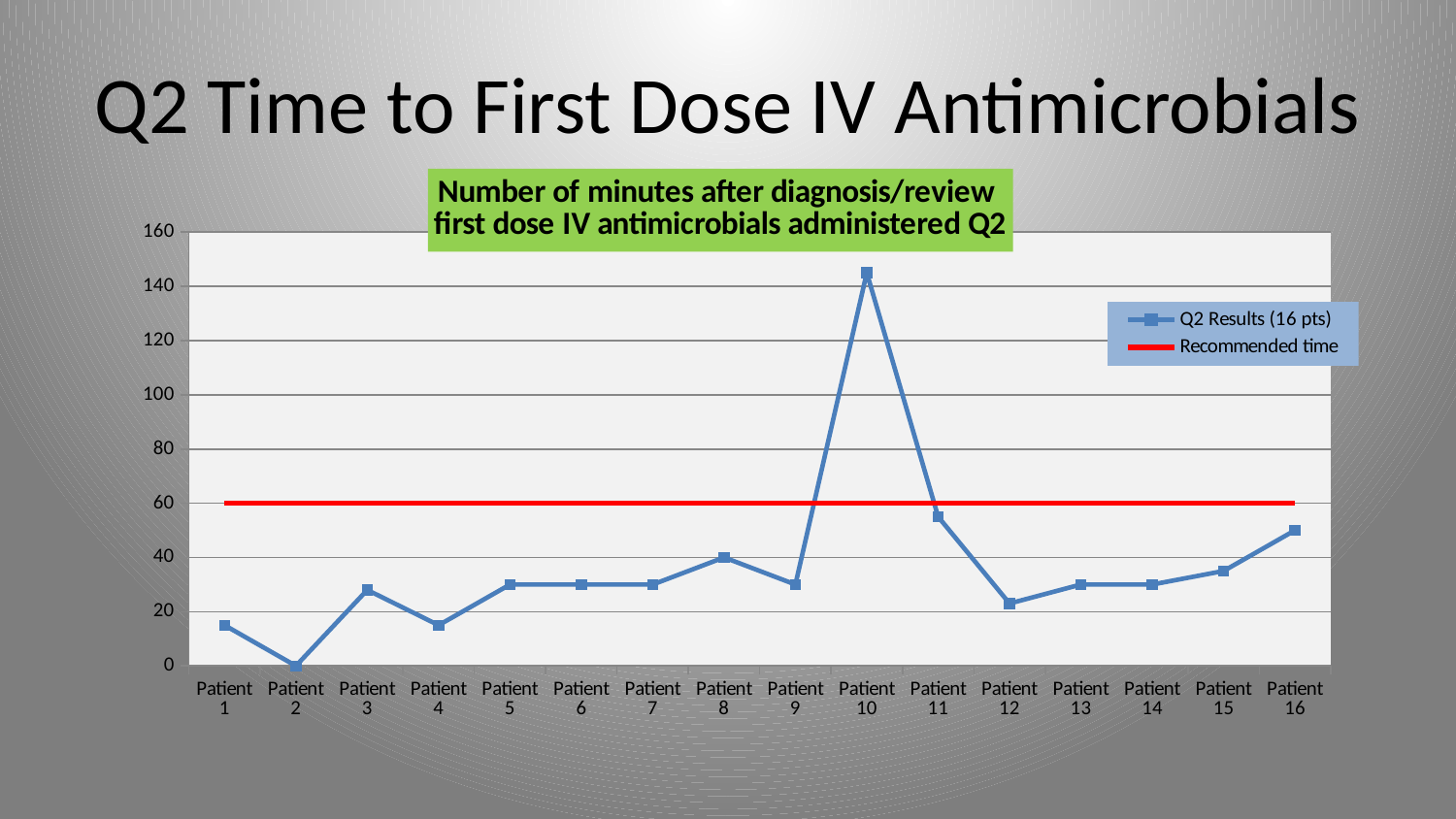
Is the value for Patient 10 greater or less than 140? greater How many series does the legend list? 2 At what value is the Recommended time line drawn? 60 What are the two entries in the chart legend? Q2 Results (16 pts) and Recommended time Which patient has the lowest number of minutes to first dose? Patient 2 What is the value for Patient 2? 0 How many patients are plotted along the x axis? 16 Is the value for Patient 12 greater or less than 40? less What is the value for Patient 8? 40 Which patient has the highest number of minutes to first dose? Patient 10 What kind of chart is shown on the slide? line chart Which is larger, the value for Patient 10 or the value for Patient 11? Patient 10